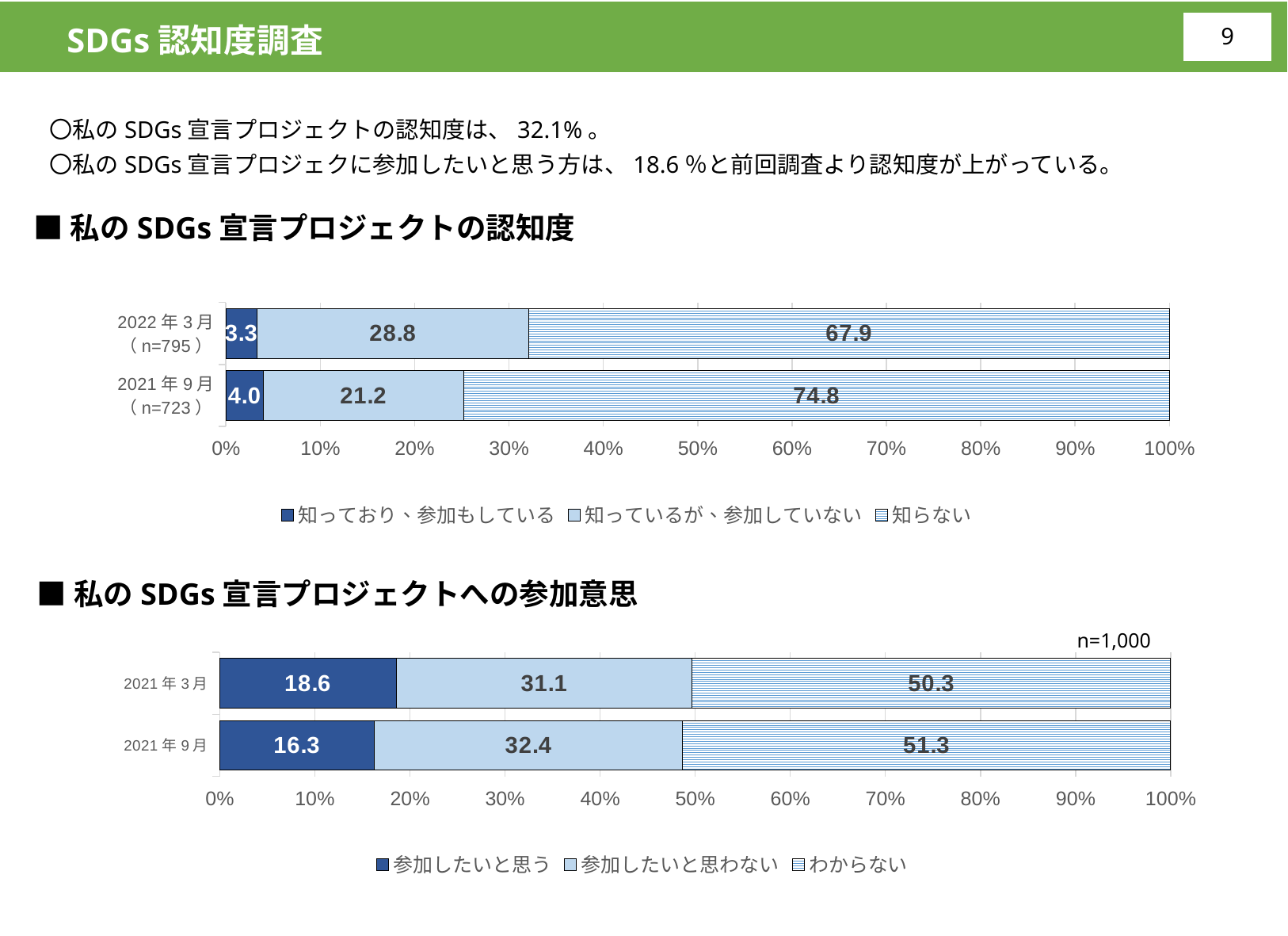
In the 私のSDGs宣言プロジェクトへの参加意思 chart, what is the difference between the 参加したいと思う values for 2021年3月 and 2021年9月? 2.3 In the 私のSDGs宣言プロジェクトへの参加意思 chart, what is the value for わからない in 2021年9月? 51.3 How many series does the legend of the 私のSDGs宣言プロジェクトの認知度 chart list? 3 In the 私のSDGs宣言プロジェクトの認知度 chart, what is the value for 知っているが、参加していない in 2021年9月? 21.2 What sample size (n) is shown for the 私のSDGs宣言プロジェクトへの参加意思 chart? n=1,000 In the 私のSDGs宣言プロジェクトの認知度 chart, which survey has the larger 知っているが、参加していない value, 2022年3月 or 2021年9月? 2022年3月 What kind of chart is the 私のSDGs宣言プロジェクトへの参加意思 chart? Stacked bar chart In the 私のSDGs宣言プロジェクトの認知度 chart, what is the value for 知らない in 2022年3月? 67.9 In the 私のSDGs宣言プロジェクトへの参加意思 chart, which segment is the largest in the 2021年3月 bar? わからない In the 私のSDGs宣言プロジェクトへの参加意思 chart, what is the value for 参加したいと思う in 2021年3月? 18.6 In the 私のSDGs宣言プロジェクトの認知度 chart, what is the value for 知っており、参加もしている in 2022年3月? 3.3 In the 私のSDGs宣言プロジェクトの認知度 chart, what is the difference between the 知らない values for 2021年9月 and 2022年3月? 6.9